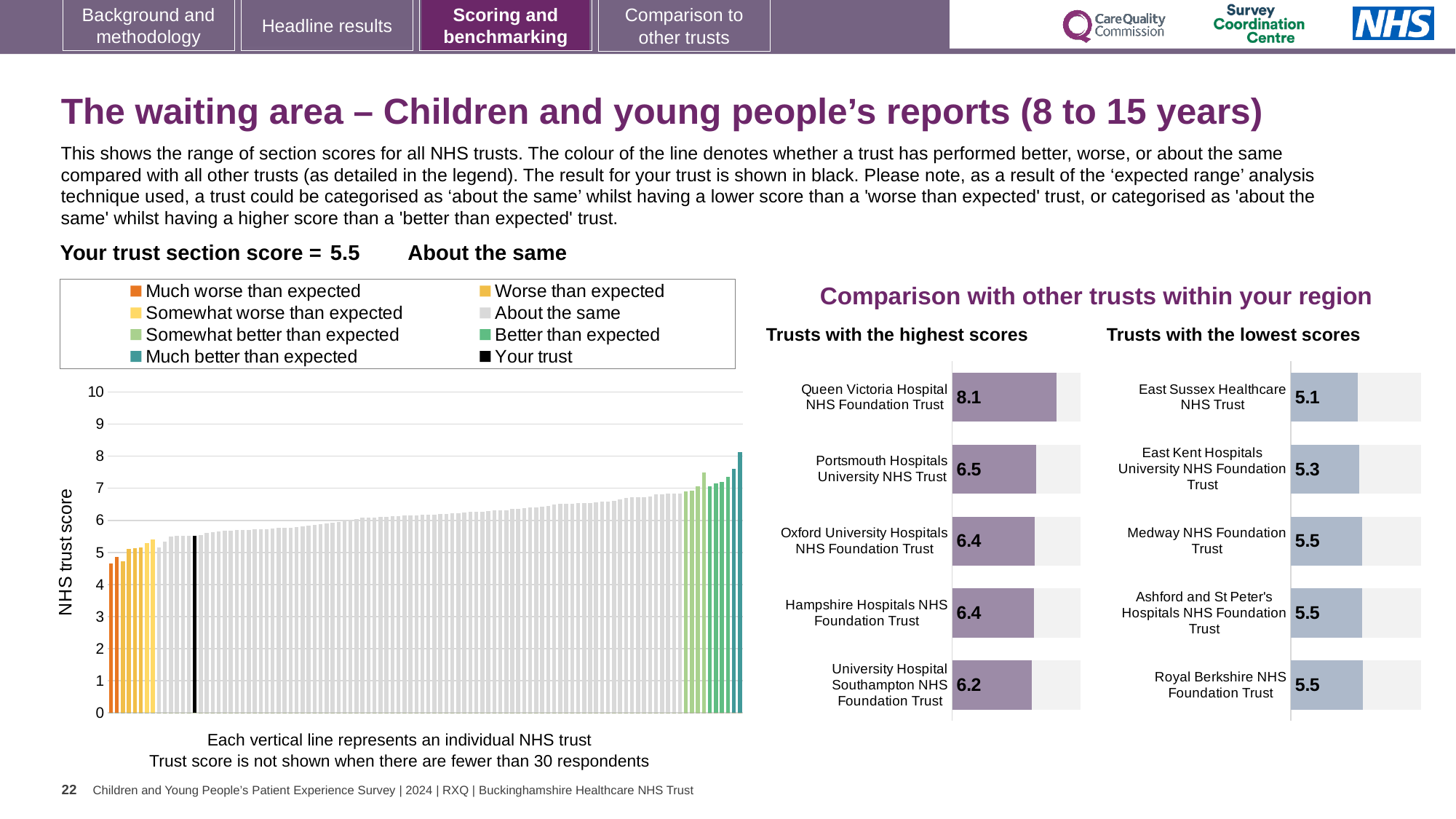
In the 'Trusts with the highest scores' chart, what is the difference between the scores of Queen Victoria Hospital NHS Foundation Trust and Portsmouth Hospitals University NHS Trust? 1.6 In the 'Trusts with the lowest scores' chart, what is the score for East Kent Hospitals University NHS Foundation Trust? 5.3 In the 'Trusts with the lowest scores' chart, which trust has the lowest score? East Sussex Healthcare NHS Trust In the 'Trusts with the lowest scores' chart, which has the larger score: East Kent Hospitals University NHS Foundation Trust or Medway NHS Foundation Trust? Medway NHS Foundation Trust How many entries does the legend above the NHS trust score chart list? 8 In the NHS trust score chart on the left, what is the section score for your trust (the black bar)? 5.5 In the 'Trusts with the highest scores' chart, which trust has the highest score? Queen Victoria Hospital NHS Foundation Trust In the NHS trust score chart on the left, is the value of the lowest (leftmost) bar greater or less than 5? less In the 'Trusts with the lowest scores' chart, how many trusts are listed? 5 In the 'Trusts with the highest scores' chart, what is the score for University Hospital Southampton NHS Foundation Trust? 6.2 In the 'Trusts with the lowest scores' chart, what is the difference between the scores of East Kent Hospitals University NHS Foundation Trust and East Sussex Healthcare NHS Trust? 0.2 In the 'Trusts with the highest scores' chart, what is the score for Queen Victoria Hospital NHS Foundation Trust? 8.1